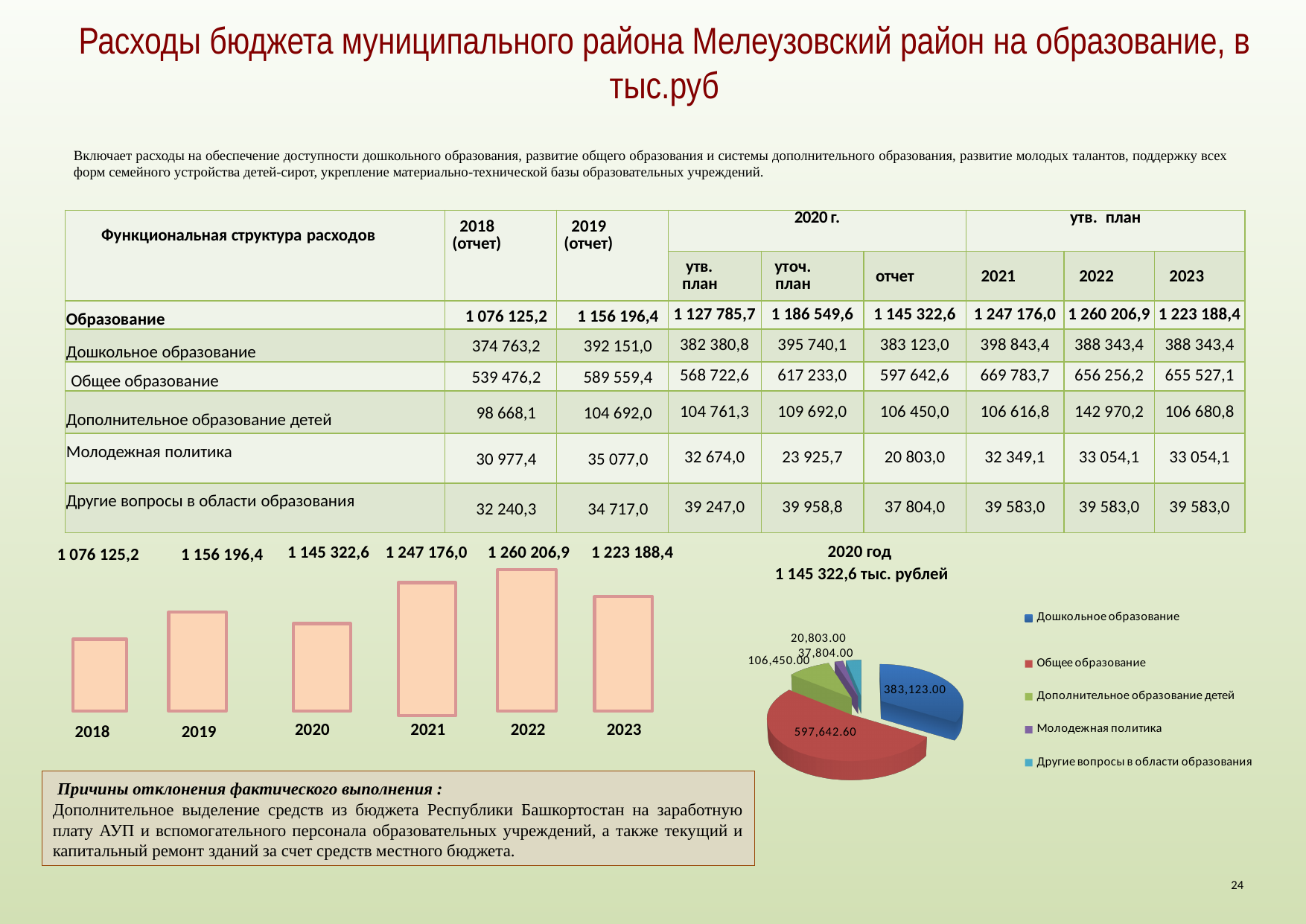
On the bar chart at the bottom left, what is the value for 2021? 1 247 176,0 On the bar chart at the bottom left, which year has the highest value? 2022 On the bar chart at the bottom left, which year has the lowest value? 2018 On the bar chart at the bottom left, does the value rise or fall from 2018 to 2019? Rise On the pie chart titled '2020 год', what is the value for Общее образование? 597,642.60 What kind of chart is the chart at the bottom left of the slide? Bar chart On the pie chart titled '2020 год', which category has the smallest slice? Молодежная политика On the bar chart at the bottom left, which is larger: the value for 2019 or the value for 2020? 2019 On the pie chart titled '2020 год', how many categories does the legend list? 5 What kind of chart is the chart titled '2020 год' on the right of the slide? Pie chart On the bar chart at the bottom left, what is the difference between the values for 2022 and 2021? 13 030,9 On the bar chart at the bottom left, how many years are shown? 6